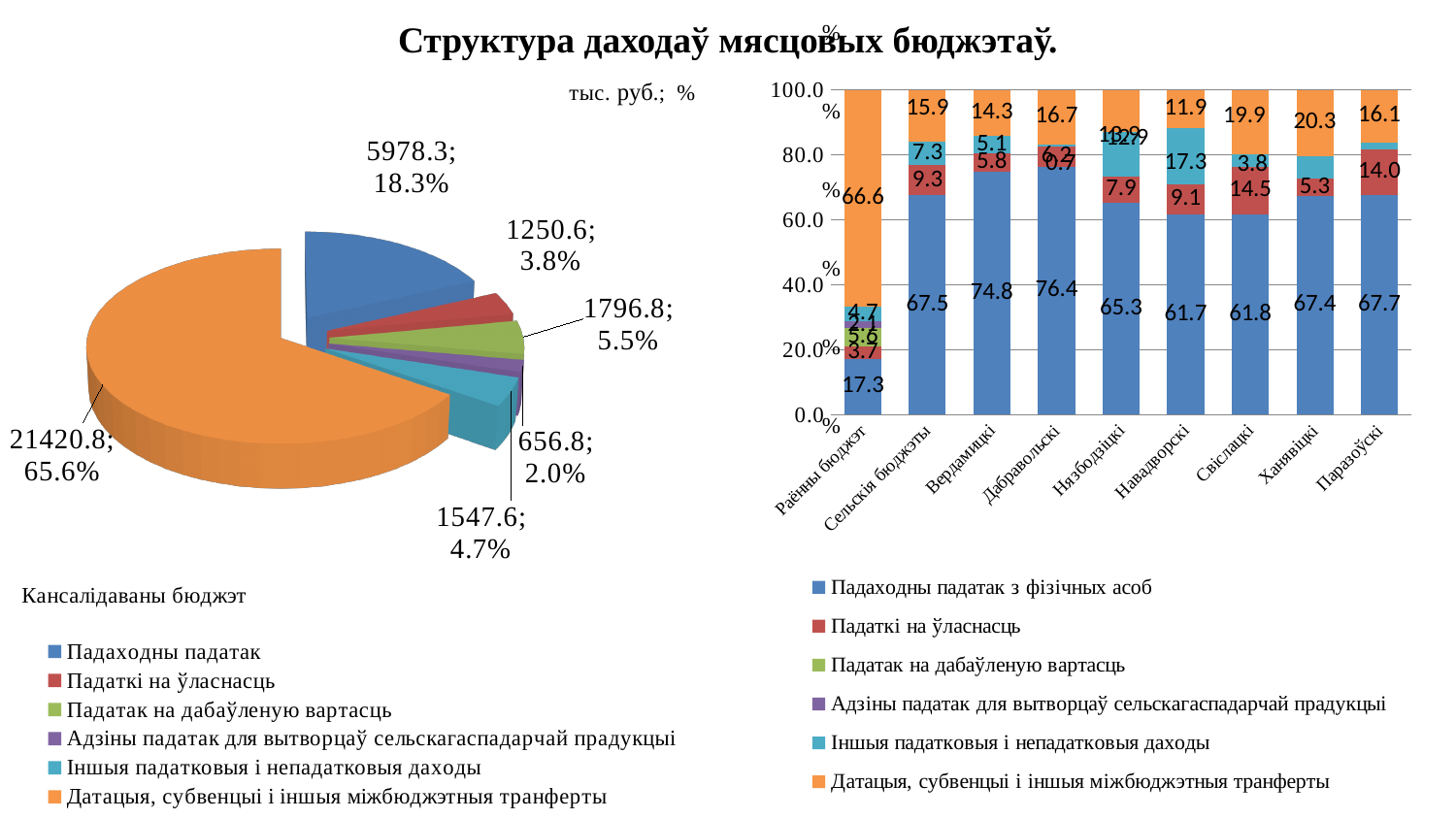
On the stacked bar chart on the right, what is the value of Датацыя, субвенцыі і іншыя міжбюджэтныя трансферты for Раённы бюджэт? 66.6 On the pie chart (Кансалідаваны бюджэт), what value and share are shown for Падаходны падатак? 5978.3; 18.3% On the stacked bar chart on the right, how many series does the legend list? 6 On the pie chart (Кансалідаваны бюджэт), what share does Датацыя, субвенцыі і іншыя міжбюджэтныя трансферты have? 65.6% On the stacked bar chart on the right, what is the value of Падаходны падатак з фізічных асоб for Дабравольскі? 76.4 On the pie chart (Кансалідаваны бюджэт), which category has the smallest slice? Адзіны падатак для вытворцаў сельскагаспадарчай прадукцыі On the stacked bar chart on the right, how many categories are shown on the x axis? 9 On the pie chart (Кансалідаваны бюджэт), what is the difference between the values for Падатак на дабаўленую вартасць and Падаткі на ўласнасць? 546.2 On the pie chart (Кансалідаваны бюджэт), how many slices are there? 6 On the stacked bar chart on the right, which category has the highest value for Падаходны падатак з фізічных асоб? Дабравольскі On the stacked bar chart on the right, is the value of Датацыя, субвенцыі і іншыя міжбюджэтныя трансферты larger for Ханявіцкі or for Навадворскі? Ханявіцкі On the stacked bar chart on the right, which category has the lowest value for Падаходны падатак з фізічных асоб? Раённы бюджэт